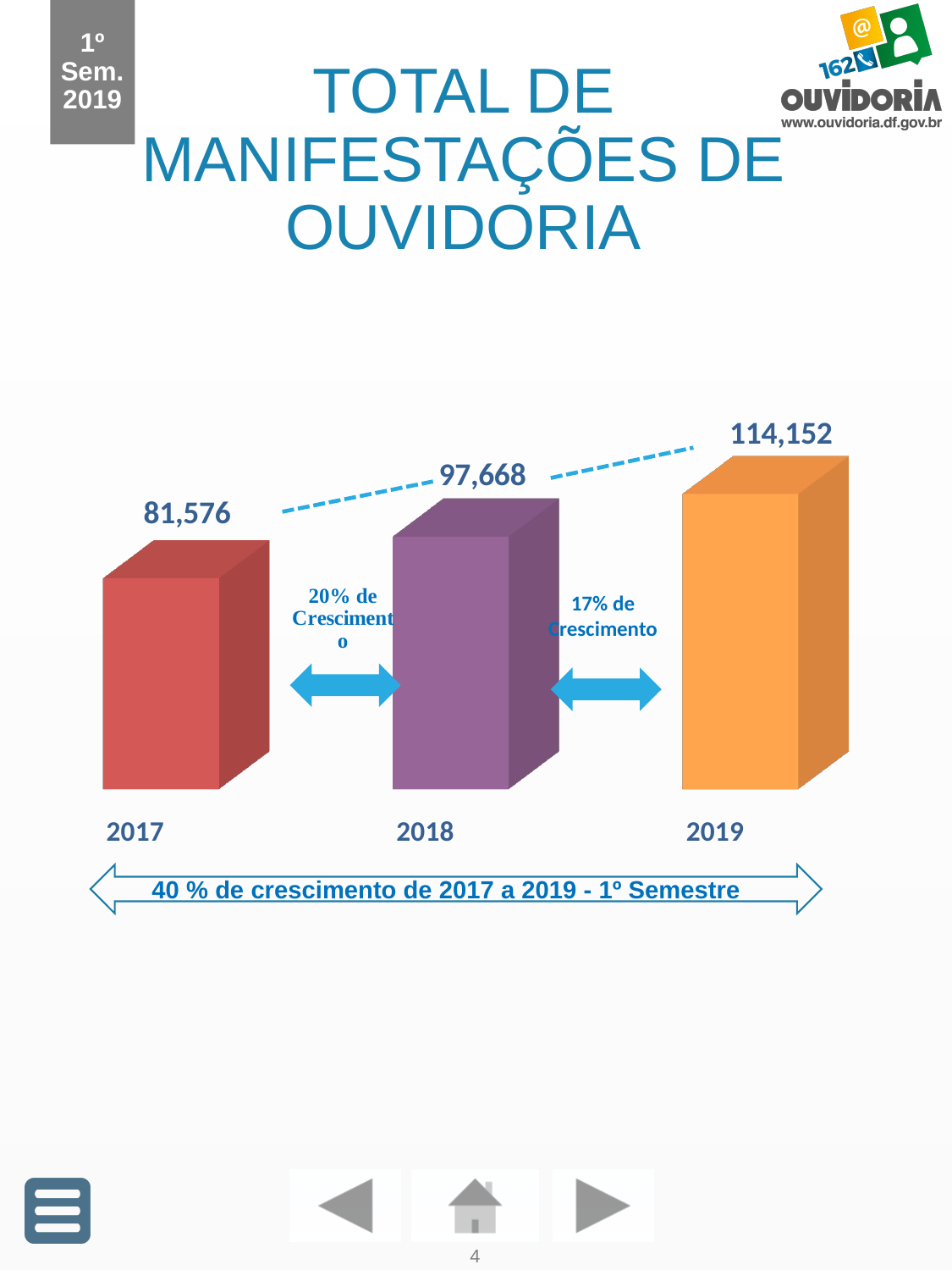
What is the value for 2018? 97,668 Do the values rise or fall from 2017 to 2019? Rise What kind of chart is shown on the slide? Bar chart What is the difference between the values for 2018 and 2017? 16,092 What is the difference between the values for 2019 and 2018? 16,484 What is the value for 2017? 81,576 How many years are shown in the chart? 3 What is the value for 2019? 114,152 Which year has the highest value? 2019 What is the difference between the values for 2019 and 2017? 32,576 Which is larger, the value for 2018 or the value for 2019? 2019 Which year has the lowest value? 2017